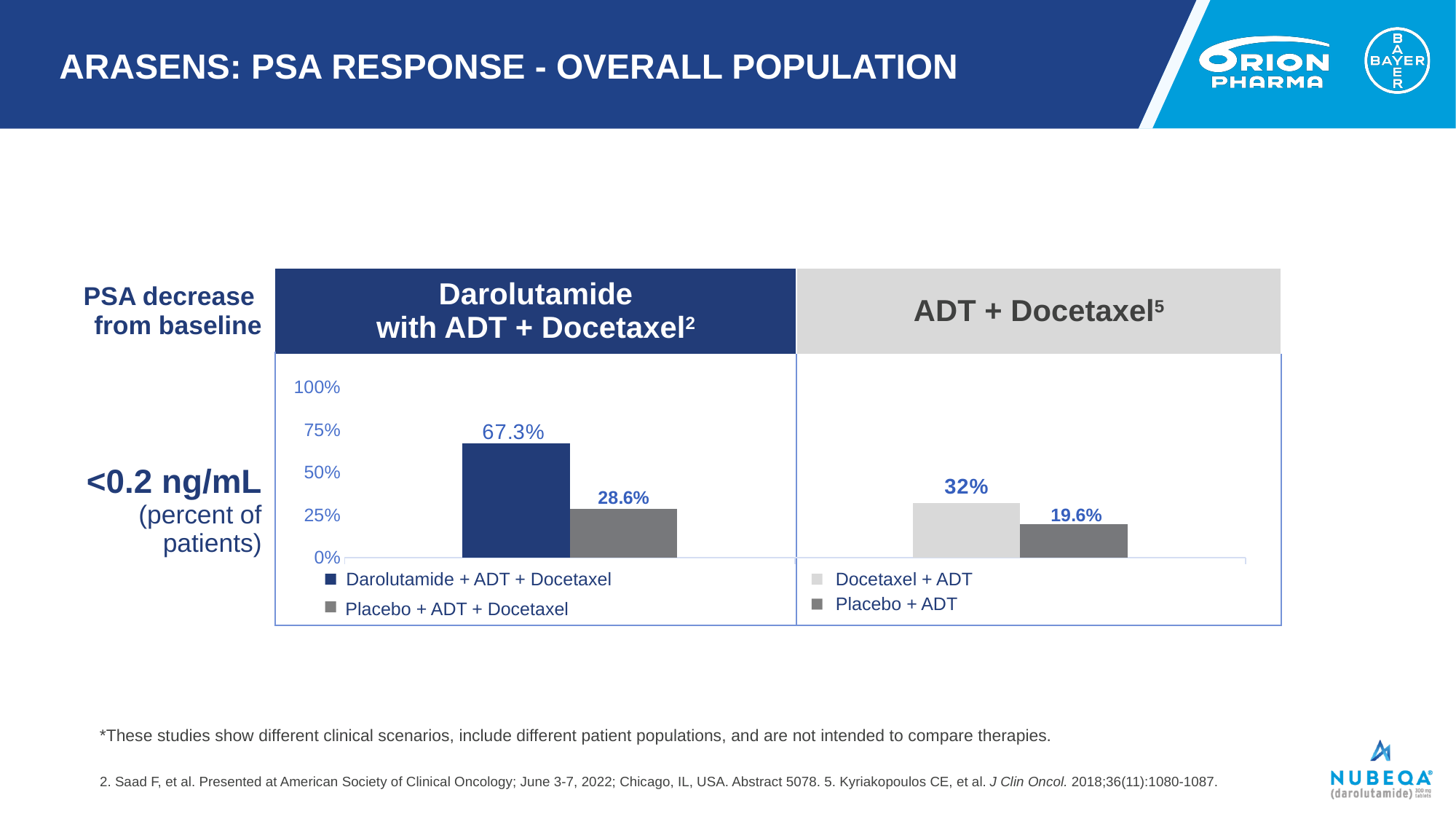
In the Darolutamide with ADT + Docetaxel chart, what is the value for Placebo + ADT + Docetaxel? 28.6% In the Darolutamide with ADT + Docetaxel chart, what percentage of patients had a PSA decrease to <0.2 ng/mL with Darolutamide + ADT + Docetaxel? 67.3% In the ADT + Docetaxel chart, what is the value for Docetaxel + ADT? 32% In the ADT + Docetaxel chart, what is the difference between the Docetaxel + ADT and Placebo + ADT values? 12.4% What kind of chart is used in the Darolutamide with ADT + Docetaxel panel? Bar chart In the ADT + Docetaxel chart, what is the value for Placebo + ADT? 19.6% In the Darolutamide with ADT + Docetaxel chart, which series has the higher value? Darolutamide + ADT + Docetaxel In the Darolutamide with ADT + Docetaxel chart, is the value for Darolutamide + ADT + Docetaxel greater or less than 50%? greater In the Darolutamide with ADT + Docetaxel chart, what is the difference between the Darolutamide + ADT + Docetaxel and Placebo + ADT + Docetaxel values? 38.7% In the ADT + Docetaxel chart, is the value for Placebo + ADT greater or less than 25%? less In the ADT + Docetaxel chart, which series has the lower value? Placebo + ADT How many series does the legend of the Darolutamide with ADT + Docetaxel chart list? 2